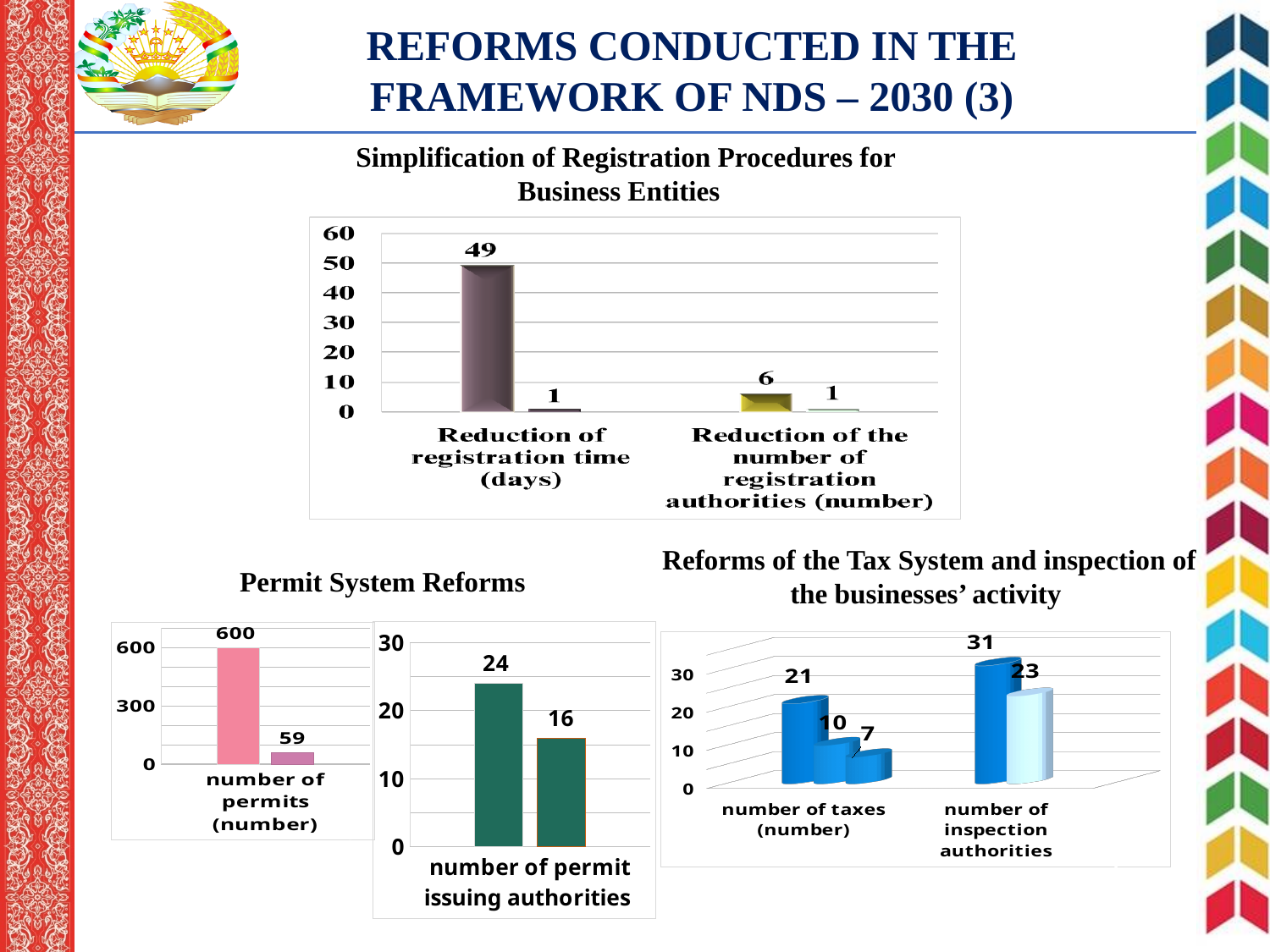
In the 'Simplification of Registration Procedures for Business Entities' chart, what is the value of the first bar for 'Reduction of the number of registration authorities (number)'? 6 In the 'Permit System Reforms' chart for 'number of permit issuing authorities', which bar is larger, the first or the second? the first In the 'Reforms of the Tax System and inspection of the businesses' activity' chart, what is the lowest value shown for 'number of taxes (number)'? 7 In the 'Simplification of Registration Procedures for Business Entities' chart, what is the highest value shown on the vertical axis? 60 In the 'Permit System Reforms' chart for 'number of permits (number)', what is the value of the shorter bar? 59 In the 'Reforms of the Tax System and inspection of the businesses' activity' chart, what is the value of the tallest bar for 'number of taxes (number)'? 21 In the 'Simplification of Registration Procedures for Business Entities' chart, what is the value of the tallest bar for 'Reduction of registration time (days)'? 49 What kind of chart is the 'Reforms of the Tax System and inspection of the businesses' activity' chart? bar chart In the 'Reforms of the Tax System and inspection of the businesses' activity' chart, what is the difference between the two bars for 'number of inspection authorities'? 8 In the 'Permit System Reforms' chart for 'number of permit issuing authorities', what is the difference between the two bars? 8 In the 'Permit System Reforms' chart for 'number of permits (number)', what is the value of the taller bar? 600 In the 'Simplification of Registration Procedures for Business Entities' chart, what is the difference between the two bars for 'Reduction of registration time (days)'? 48